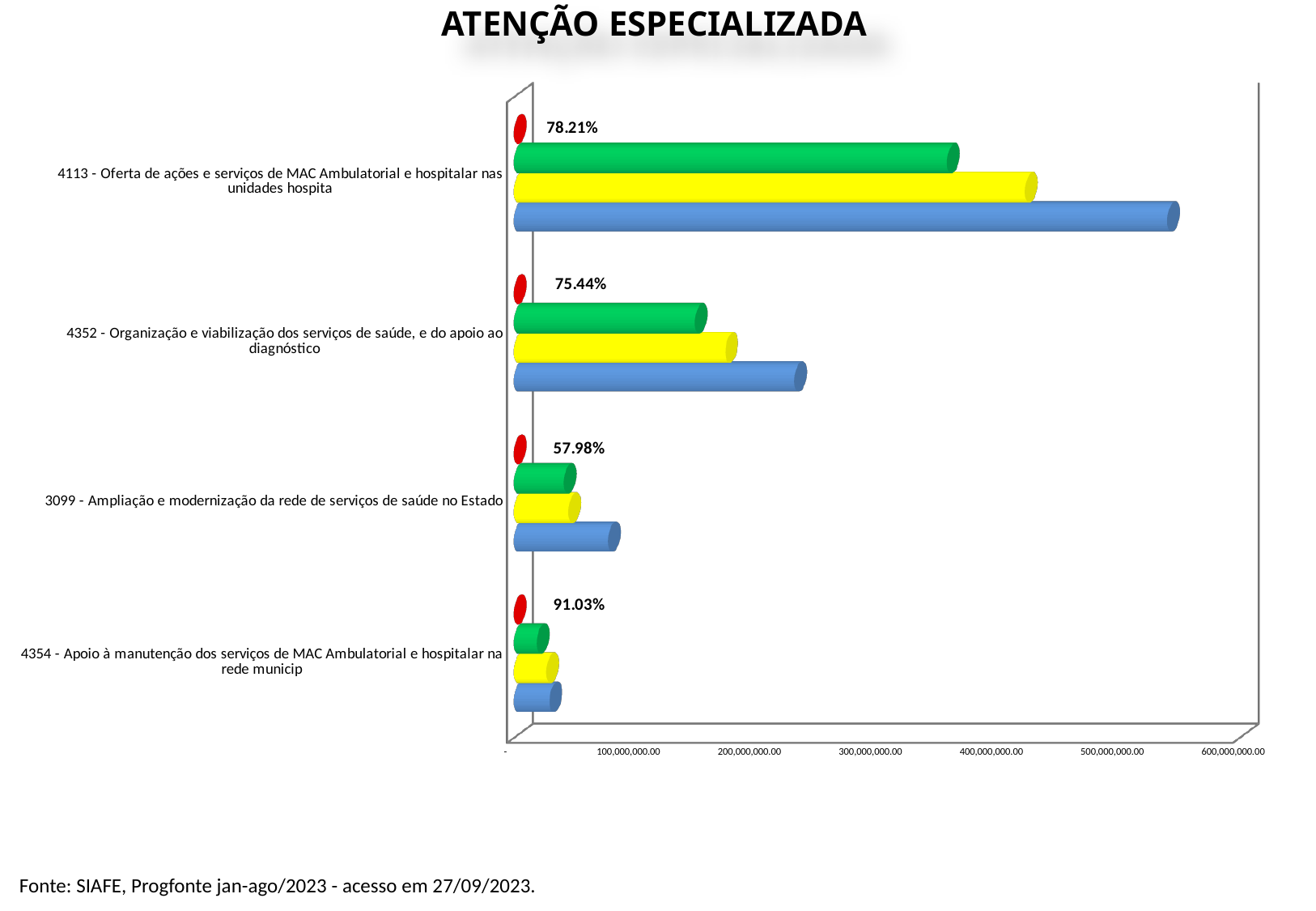
How many categories are shown on the chart? 4 What type of chart is shown on the slide? Bar chart Which category has the lowest percentage label? 3099 - Ampliação e modernização da rede de serviços de saúde no Estado What percentage is shown for category 4354 - Apoio à manutenção dos serviços de MAC Ambulatorial e hospitalar na rede municip? 91.03% Is the blue bar for category 4352 greater or less than 300,000,000.00? less What percentage is shown for category 3099 - Ampliação e modernização da rede de serviços de saúde no Estado? 57.98% Is the blue bar for category 4113 greater or less than 500,000,000.00? greater What percentage is shown for category 4113 - Oferta de ações e serviços de MAC Ambulatorial e hospitalar nas unidades hospita? 78.21% What percentage is shown for category 4352 - Organização e viabilização dos serviços de saúde, e do apoio ao diagnóstico? 75.44% What is the difference in percentage points between the labels for category 4354 and category 3099? 33.05 Which category has the longer blue bar, 4113 or 4352? 4113 Which category has the highest percentage label? 4354 - Apoio à manutenção dos serviços de MAC Ambulatorial e hospitalar na rede municip